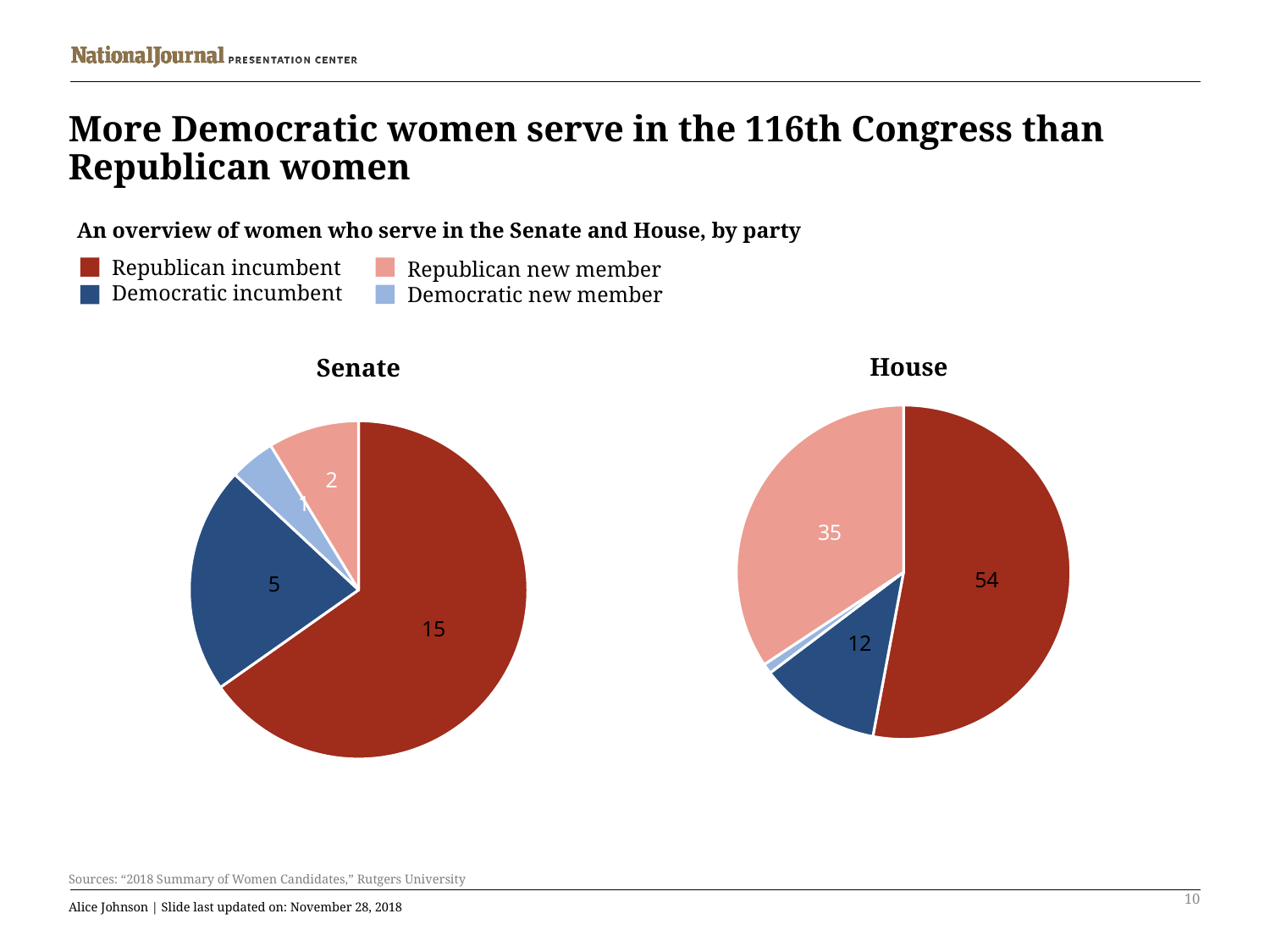
In the House pie chart, which is larger: Republican new member or Democratic incumbent? Republican new member In the Senate pie chart, what is the value for Republican incumbent? 15 In the House pie chart, what is the value for Democratic incumbent? 12 In the House pie chart, what is the value for Republican incumbent? 54 In the Senate pie chart, what is the value for Democratic incumbent? 5 In the House pie chart, what is the difference between Republican incumbent and Republican new member? 19 How many categories does the legend list for the charts? 4 In the House pie chart, which category has the largest slice? Republican incumbent In the House pie chart, what is the value for Republican new member? 35 In the Senate pie chart, what is the value for Republican new member? 2 In the House pie chart, which category has the smallest slice? Democratic new member In the Senate pie chart, what is the difference between Republican incumbent and Democratic incumbent? 10